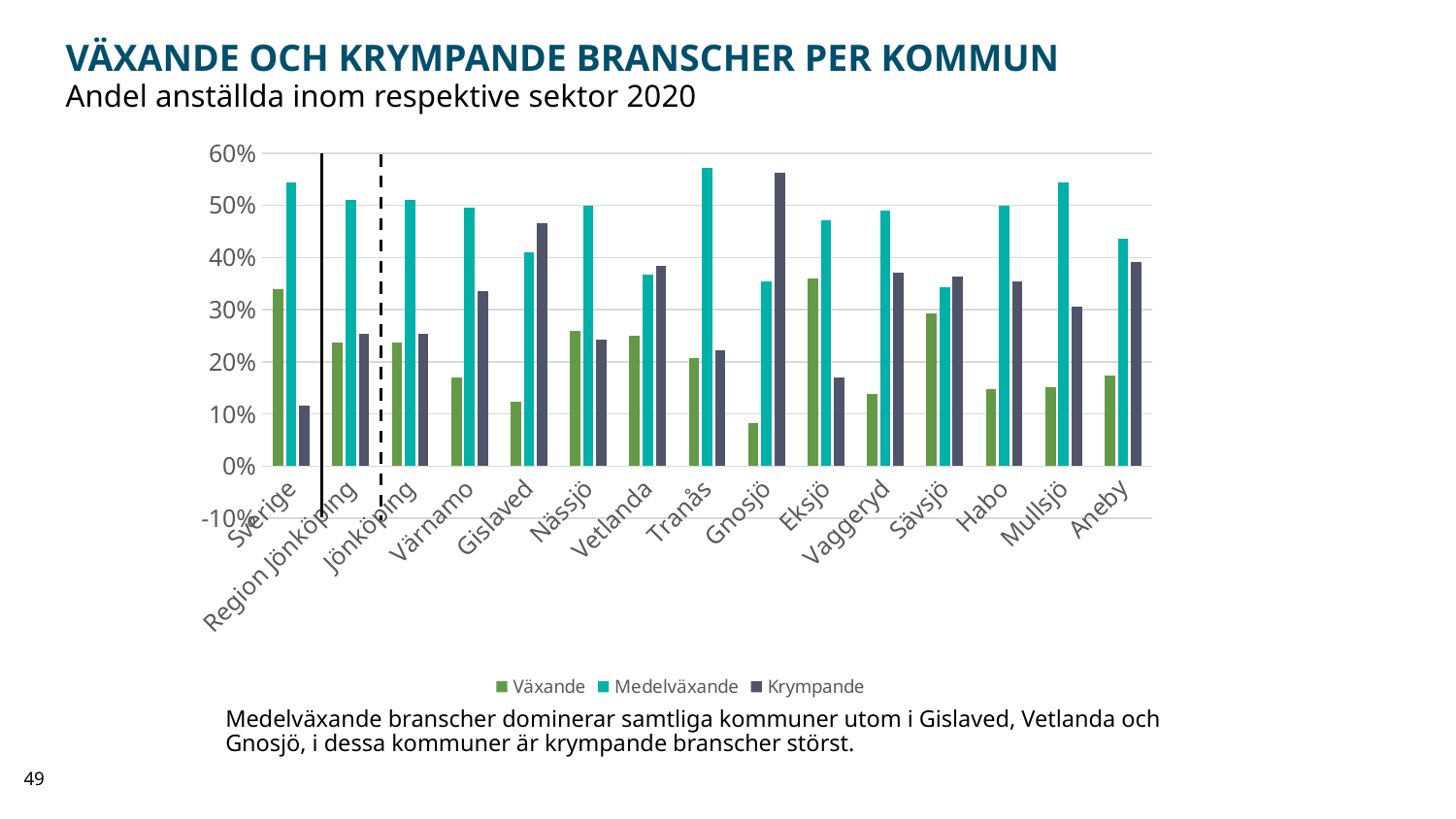
How many series does the legend list? 3 Is the Medelväxande value for Tranås greater or less than 50%? greater Which category has the highest value for Krympande? Gnosjö What is the title of the chart? VÄXANDE OCH KRYMPANDE BRANSCHER PER KOMMUN Which category has the lowest value for Krympande? Sverige In Gislaved, which is larger: Medelväxande or Krympande? Krympande Which category has the highest value for Medelväxande? Tranås Which category has the lowest value for Växande? Gnosjö What kind of chart is shown on the slide? Bar chart Is the Växande value for Gislaved greater or less than 20%? less Is the Krympande value for Gnosjö greater or less than 50%? greater How many categories are shown on the x axis? 15